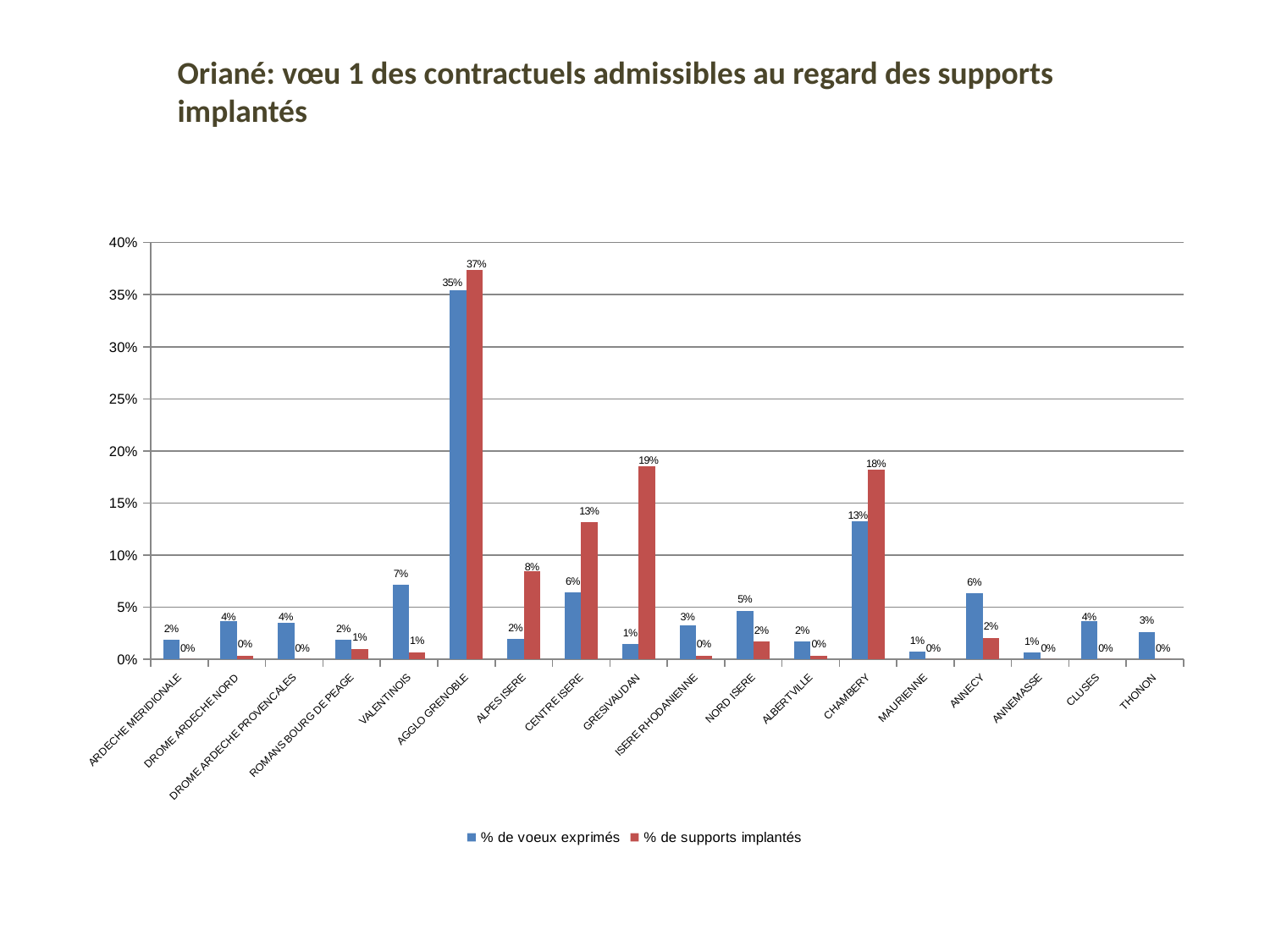
What kind of chart is shown on the slide? Bar chart What is the value of "% de supports implantés" for CHAMBERY? 18% How many categories are shown on the x axis? 18 What is the value of "% de supports implantés" for GRESIVAUDAN? 19% For VALENTINOIS, which is larger: "% de voeux exprimés" or "% de supports implantés"? % de voeux exprimés What is the difference between "% de supports implantés" and "% de voeux exprimés" for CENTRE ISERE? 7% What is the difference between "% de supports implantés" and "% de voeux exprimés" for GRESIVAUDAN? 18% What is the value of "% de voeux exprimés" for AGGLO GRENOBLE? 35% How many series does the legend list? 2 Is the value of "% de supports implantés" for AGGLO GRENOBLE greater or less than 35%? greater For ALPES ISERE, which is larger: "% de voeux exprimés" or "% de supports implantés"? % de supports implantés Which category has the highest value for "% de supports implantés"? AGGLO GRENOBLE